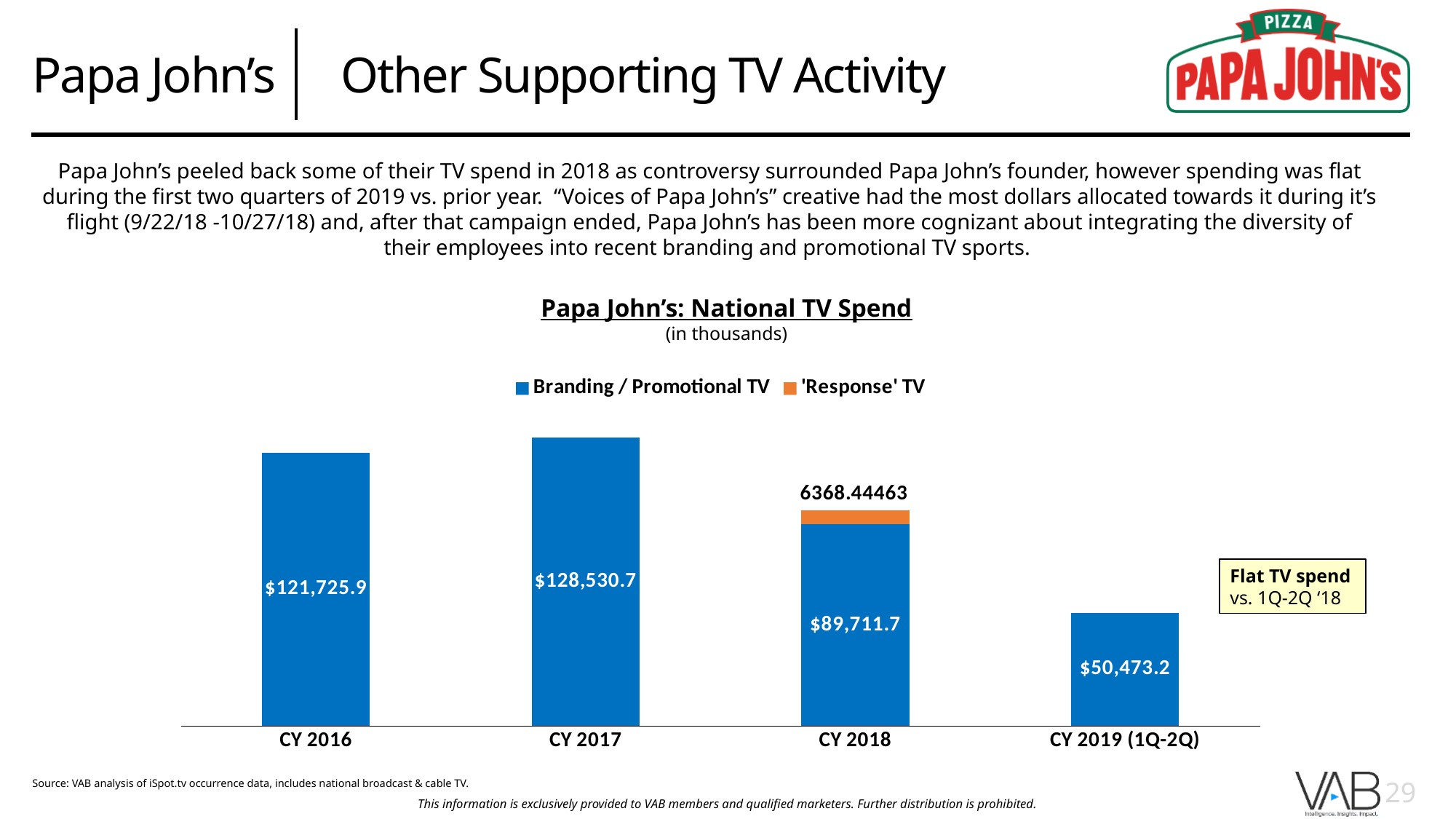
What kind of chart is shown on the slide? Stacked bar chart What is the 'Response' TV value shown for CY 2018? 6368.44463 Which year has the highest Branding / Promotional TV spend? CY 2017 What is the Branding / Promotional TV spend for CY 2018? $89,711.7 How many series does the legend list? 2 What is the Branding / Promotional TV spend for CY 2016? $121,725.9 What is the Branding / Promotional TV spend for CY 2019 (1Q-2Q)? $50,473.2 Is the Branding / Promotional TV spend larger in CY 2016 or CY 2018? CY 2016 How many categories are shown on the x axis? 4 How much higher is the Branding / Promotional TV spend in CY 2017 than in CY 2016? $6,804.8 Which category has the lowest Branding / Promotional TV spend? CY 2019 (1Q-2Q) Does the Branding / Promotional TV spend rise or fall from CY 2017 to CY 2019 (1Q-2Q)? Fall